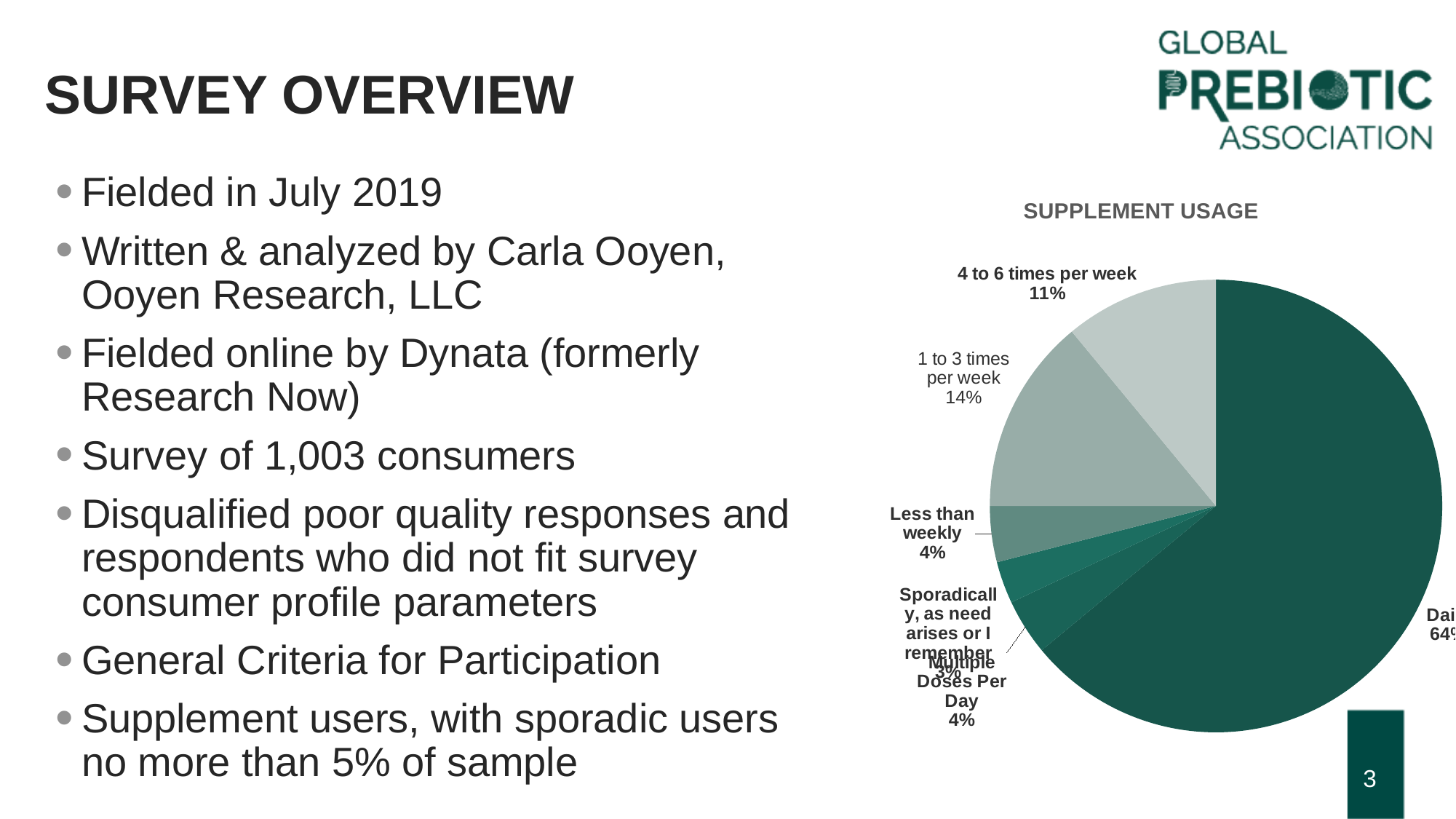
What share of the pie is labelled 'Multiple Doses Per Day'? 4% What kind of chart is shown on the slide? pie chart How many slices does the pie chart have? 6 What is the difference in percentage points between '1 to 3 times per week' and '4 to 6 times per week'? 3 percentage points What share of the pie is labelled 'Less than weekly'? 4% What is the combined share of '1 to 3 times per week' and '4 to 6 times per week'? 25% What share of the pie is labelled '1 to 3 times per week'? 14% Which is larger: '1 to 3 times per week' or '4 to 6 times per week'? 1 to 3 times per week Which slice is smaller: 'Sporadically, as need arises or I remember' or 'Less than weekly'? Sporadically, as need arises or I remember What share of the pie is labelled 'Sporadically, as need arises or I remember'? 3% What share of the pie is labelled '4 to 6 times per week'? 11% What is the title of the chart on the slide? SUPPLEMENT USAGE